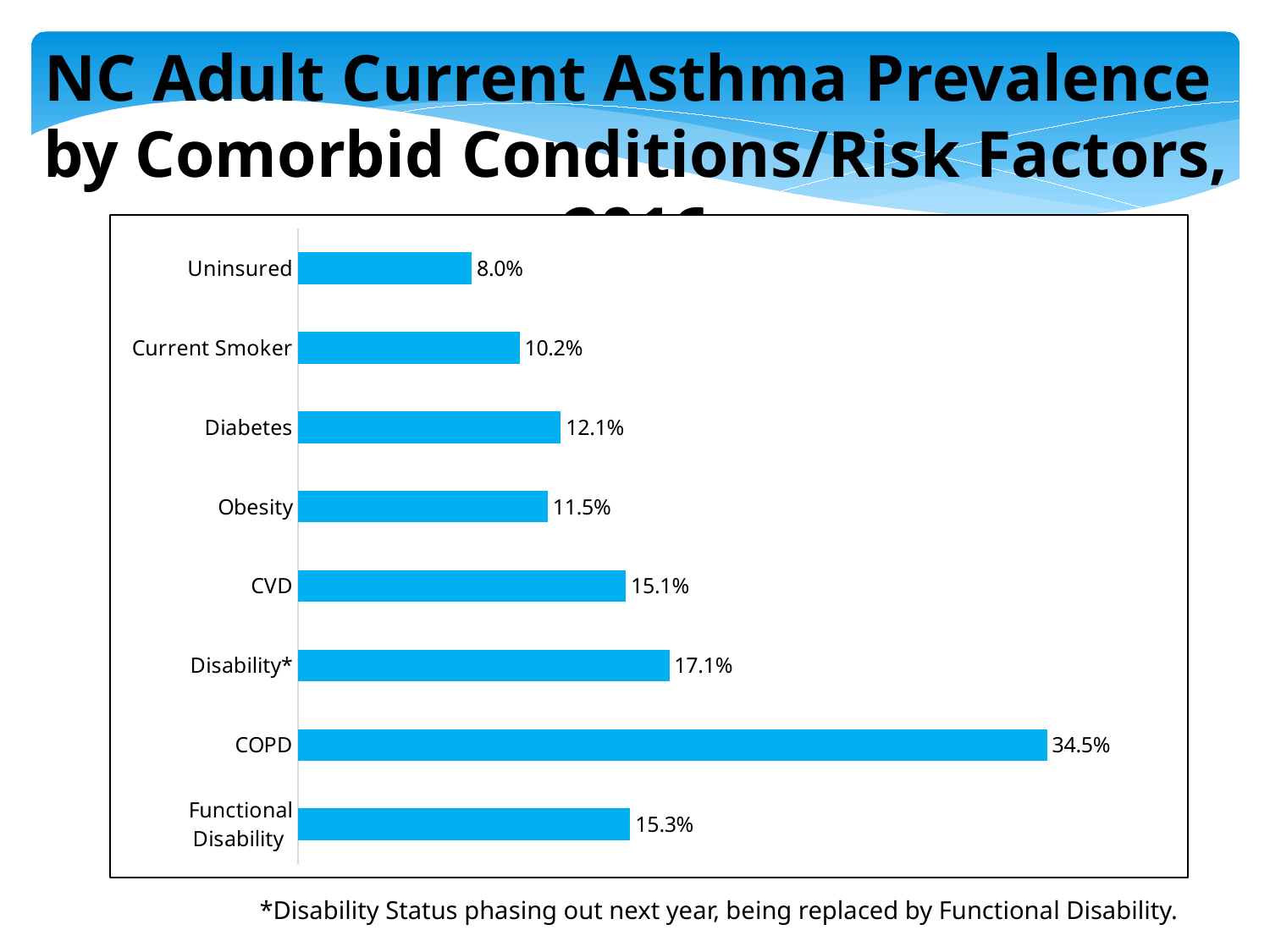
How many categories are shown in the chart? 8 What is the difference in asthma prevalence between COPD and Disability*? 17.4% What is the asthma prevalence for adults with Diabetes? 12.1% Which has a higher asthma prevalence, Diabetes or Obesity? Diabetes Which has a higher asthma prevalence, CVD or Disability*? Disability* What is the difference in asthma prevalence between Current Smoker and Uninsured? 2.2% What type of chart is shown on the slide? Bar chart What is the asthma prevalence for Uninsured adults? 8.0% What is the asthma prevalence for adults with COPD? 34.5% Which category has the highest asthma prevalence? COPD Which category has the lowest asthma prevalence? Uninsured What is the asthma prevalence for adults with Functional Disability? 15.3%